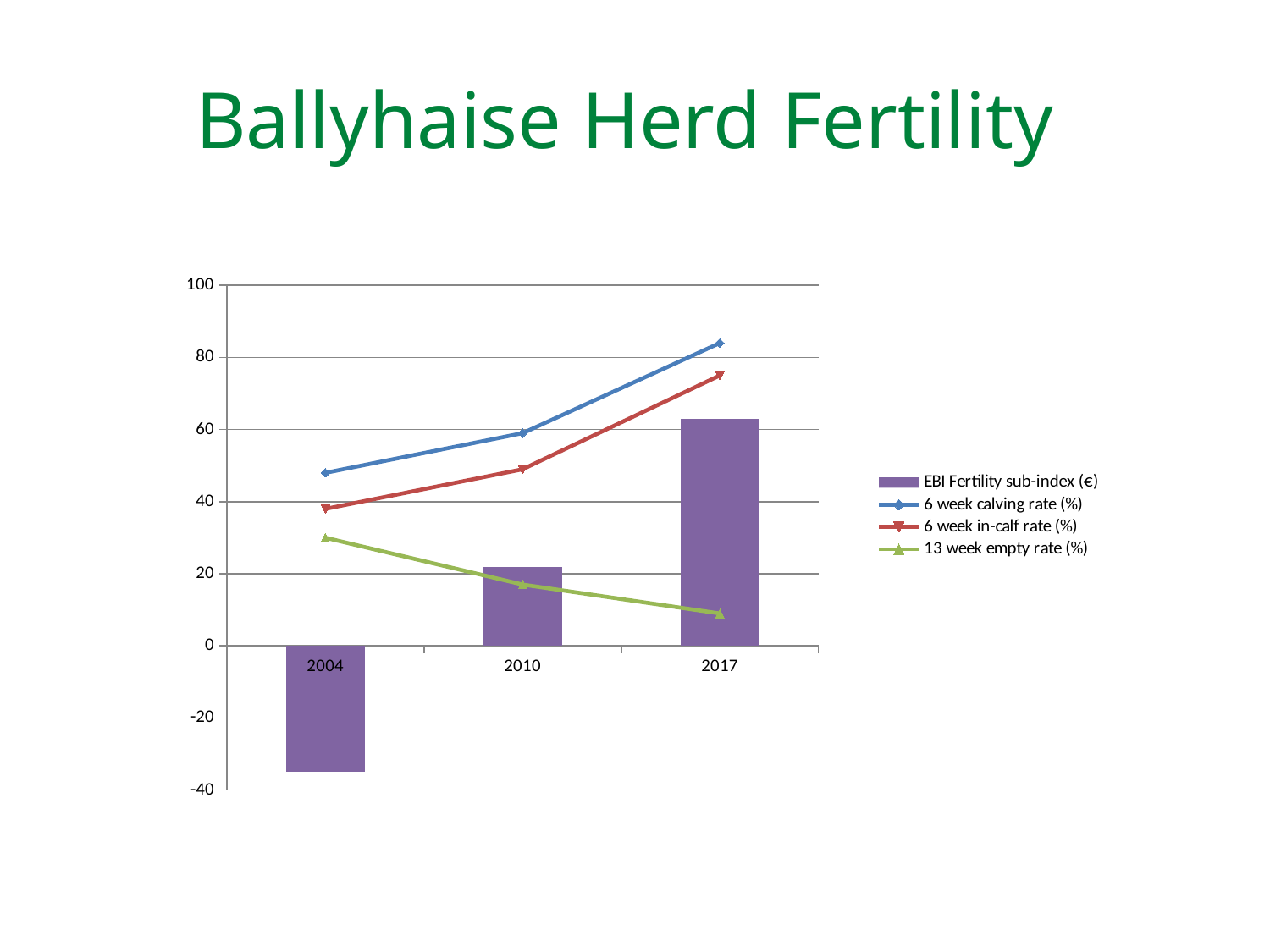
What kind of chart is this? Combined bar and line chart Does the 13 week empty rate (%) rise or fall from 2004 to 2017? fall Does the 6 week in-calf rate (%) rise or fall from 2004 to 2017? rise Is the 13 week empty rate (%) for 2017 greater or less than 20? less In 2010, which is larger: the 6 week calving rate (%) or the 6 week in-calf rate (%)? 6 week calving rate (%) Which series is plotted as bars rather than a line? EBI Fertility sub-index (€) How many series does the legend list? 4 Which year has the lowest EBI Fertility sub-index (€)? 2004 Is the EBI Fertility sub-index (€) for 2004 greater or less than 0? less Is the 6 week calving rate (%) for 2017 greater or less than 80? greater Which year has the highest EBI Fertility sub-index (€)? 2017 How many years are shown on the x axis? 3